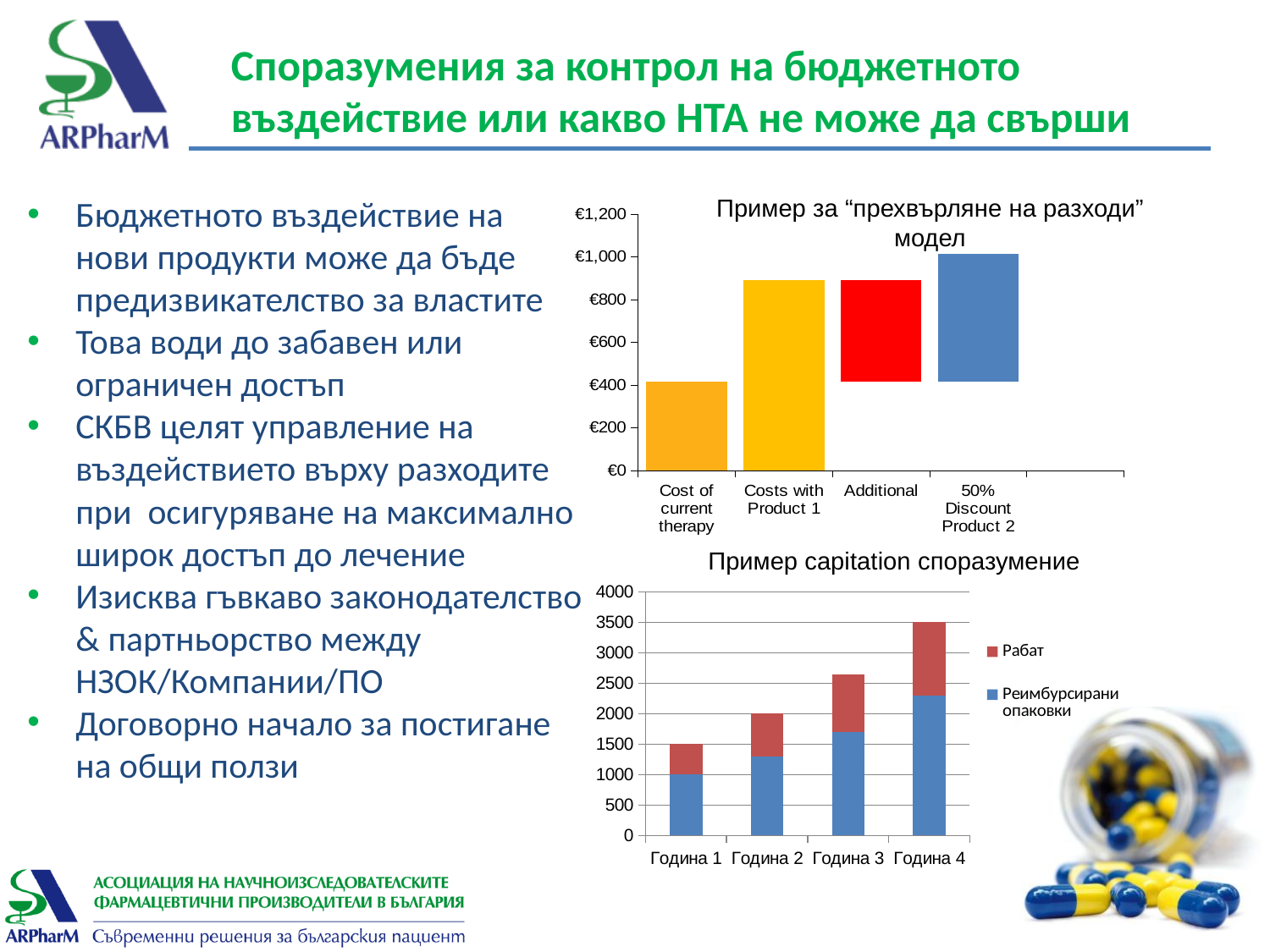
In the bottom chart ("Пример capitation споразумение"), which year has the highest total bar? Година 4 In the top chart ("Пример за “прехвърляне на разходи” модел"), is the value for Costs with Product 1 greater or less than €800? greater What kind of chart is the top chart titled "Пример за “прехвърляне на разходи” модел"? bar chart In the bottom chart ("Пример capitation споразумение"), do the total bar heights rise or fall from Година 1 to Година 4? rise In the top chart ("Пример за “прехвърляне на разходи” модел"), is the value for Cost of current therapy greater or less than €600? less In the bottom chart ("Пример capitation споразумение"), is the Реимбурсирани опаковки value for Година 1 greater or less than 1500? less How many categories are shown on the x axis of the top chart ("Пример за “прехвърляне на разходи” модел")? 4 In the top chart ("Пример за “прехвърляне на разходи” модел"), which category has the lowest bar? Cost of current therapy What are the legend entries of the bottom chart ("Пример capitation споразумение")? Рабат, Реимбурсирани опаковки How many series does the legend of the bottom chart ("Пример capitation споразумение") list? 2 In the top chart ("Пример за “прехвърляне на разходи” модел"), which category's bar reaches the highest point on the axis? 50% Discount Product 2